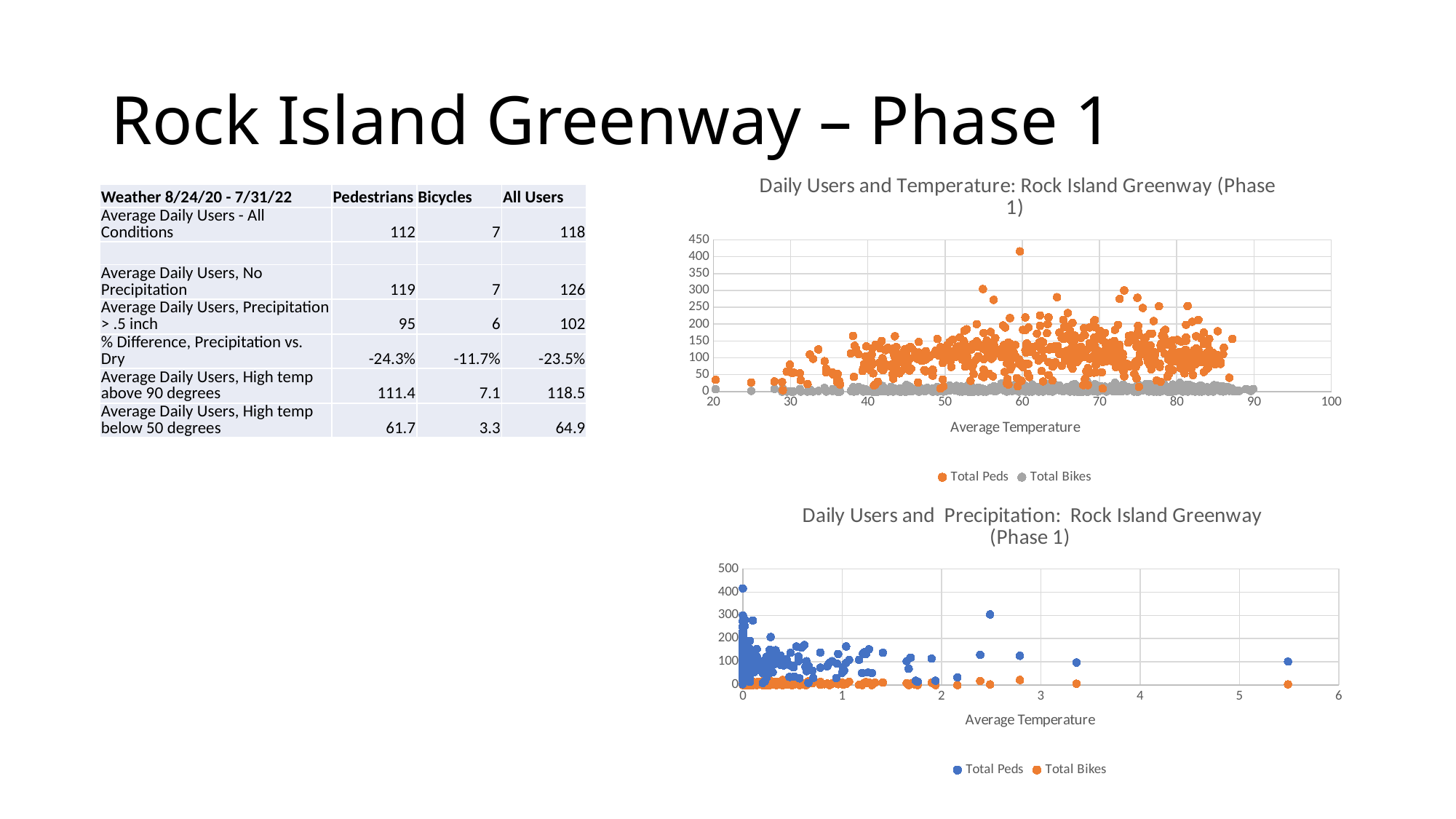
How many series does the legend of the 'Daily Users and Temperature' chart list? 2 How many series does the legend of the 'Daily Users and Precipitation' chart list? 2 In the 'Daily Users and Precipitation' chart, which series generally has higher values, Total Peds or Total Bikes? Total Peds What kind of chart is the 'Daily Users and Precipitation: Rock Island Greenway (Phase 1)' chart? scatter chart In the 'Daily Users and Temperature' chart, is the highest Total Bikes value greater or less than 100? less In the 'Daily Users and Precipitation' chart, is the highest Total Peds value greater or less than 400? greater In the 'Daily Users and Temperature' chart, which series generally has higher values, Total Peds or Total Bikes? Total Peds In the 'Daily Users and Precipitation' chart, is the highest Total Bikes value greater or less than 100? less What are the two legend entries in the 'Daily Users and Temperature' chart? Total Peds and Total Bikes What is the x-axis title of the 'Daily Users and Temperature' chart? Average Temperature What kind of chart is the 'Daily Users and Temperature: Rock Island Greenway (Phase 1)' chart? scatter chart